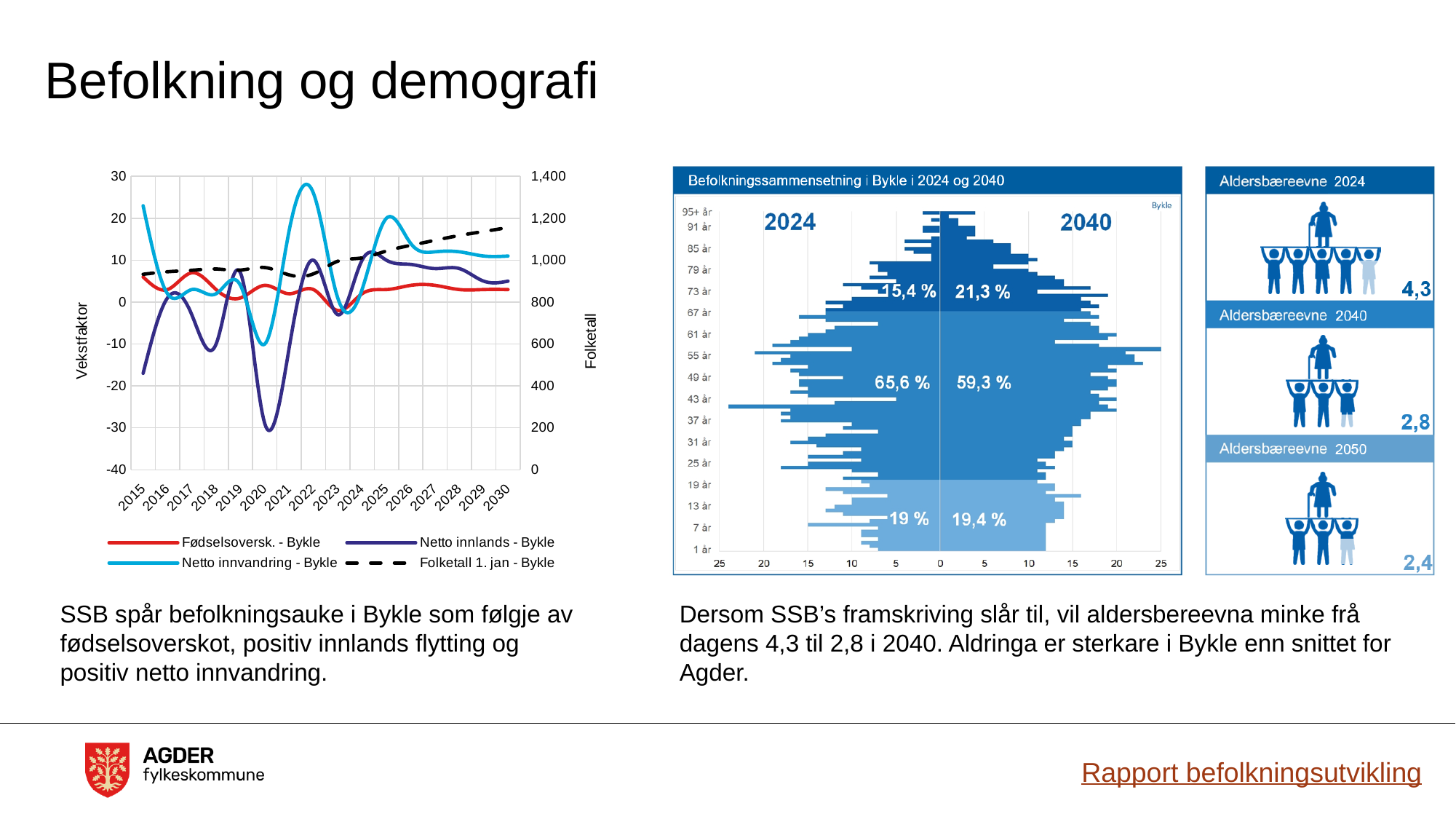
In the left-hand line chart, does the dashed Folketall 1. jan - Bykle line rise or fall from 2015 to 2030? rise In the left-hand line chart, is the value for Netto innlands - Bykle in 2020 greater or less than -20? less In the chart 'Befolkningssammensetning i Bykle i 2024 og 2040', by how many percentage points does the oldest group's share in 2040 exceed its share in 2024? 5,9 percentage points In the left-hand line chart, is the Folketall 1. jan - Bykle value in 2030 greater or less than 1,000 on the right axis? greater How many series does the legend of the left-hand line chart list? 4 What kind of chart is the left-hand chart with the Vekstfaktor axis? line chart In the chart 'Befolkningssammensetning i Bykle i 2024 og 2040', which year has the larger share in the middle group, 2024 or 2040? 2024 In the Aldersbæreevne panels on the right, what is the value for 2050? 2,4 In the Aldersbæreevne panels on the right, what is the difference between the 2024 value and the 2040 value? 1,5 In the chart 'Befolkningssammensetning i Bykle i 2024 og 2040', what share of the population is in the middle (working-age) group in 2024? 65,6 % In the left-hand line chart, is the value for Netto innvandring - Bykle in 2022 greater or less than 20? greater In the chart 'Befolkningssammensetning i Bykle i 2024 og 2040', what share of the population is in the oldest group in 2040? 21,3 %